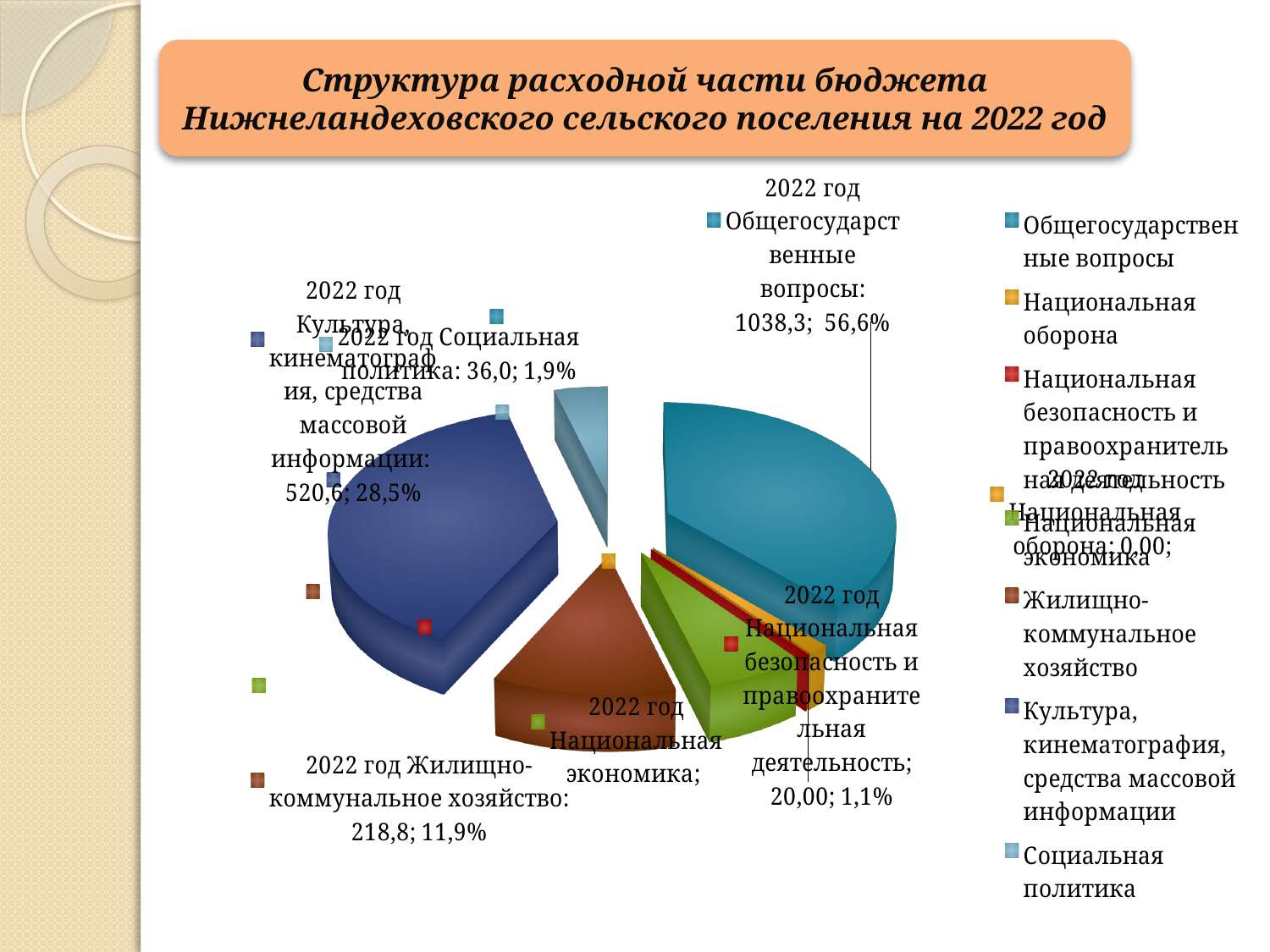
What is the value shown for Культура, кинематография, средства массовой информации? 520,6 Which category has the largest share of the pie? Общегосударственные вопросы What share of the pie does Общегосударственные вопросы take? 56,6% What year does the chart title refer to? 2022 год What kind of chart is shown on the slide? pie chart How many categories does the legend list? 7 What is the value shown for Социальная политика? 36,0 Which is larger: the value for Жилищно-коммунальное хозяйство or the value for Социальная политика? Жилищно-коммунальное хозяйство What percentage is shown for Национальная безопасность и правоохранительная деятельность? 1,1% What percentage is shown for Жилищно-коммунальное хозяйство? 11,9% What is the difference between the values for Общегосударственные вопросы and Культура, кинематография, средства массовой информации? 517,7 What is the value shown for Общегосударственные вопросы? 1038,3